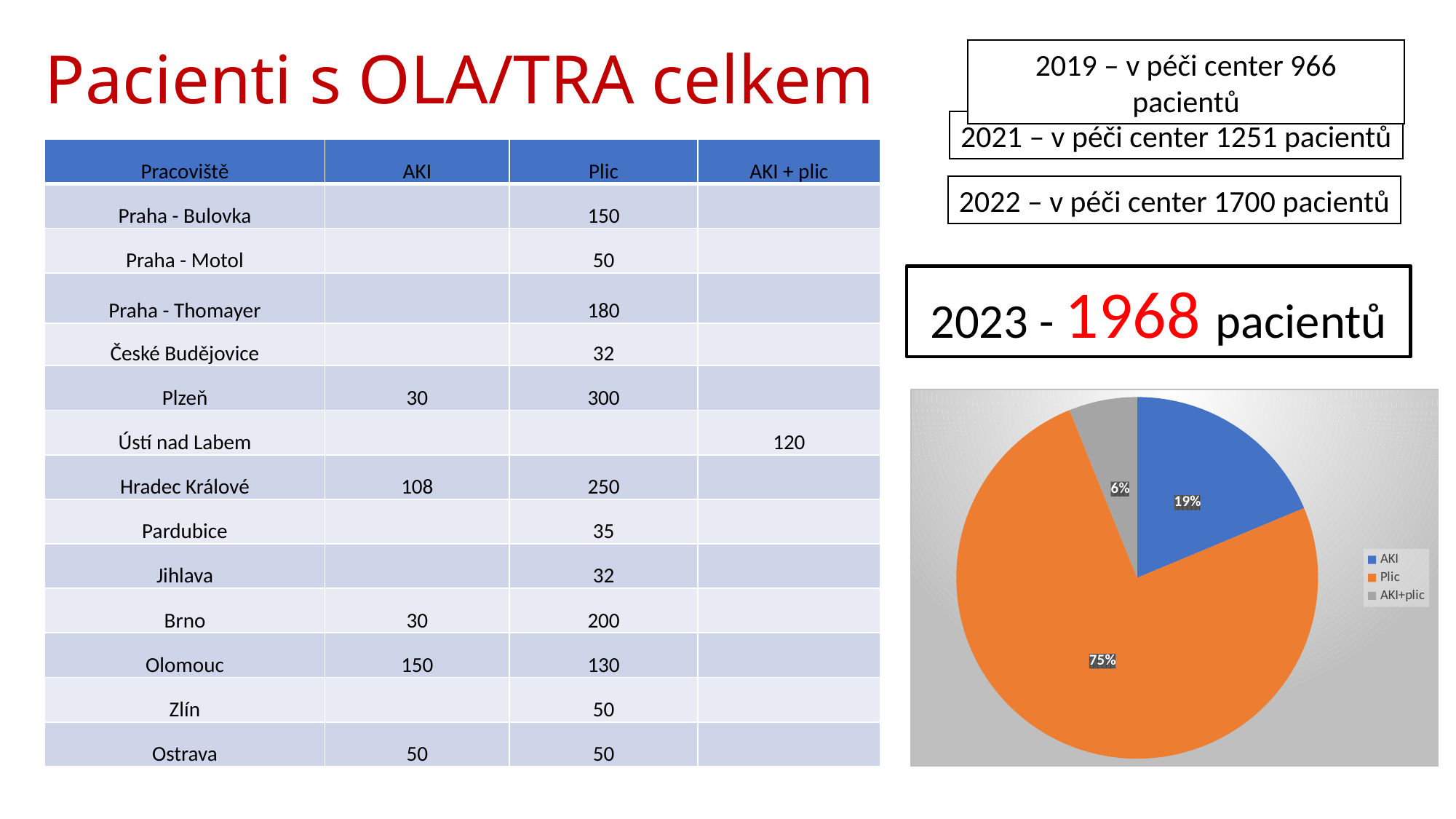
Which is larger in the pie chart, the AKI slice or the AKI+plic slice? AKI What share of the pie chart does the AKI+plic slice represent? 6% How many slices does the pie chart have? 3 What is the difference in percentage points between the Plic slice and the AKI slice in the pie chart? 56 What kind of chart is shown on the slide? pie chart Which category has the largest slice in the pie chart? Plic How many entries does the pie chart legend list? 3 Which category has the smallest slice in the pie chart? AKI+plic What are the legend entries of the pie chart, in order? AKI, Plic, AKI+plic What share of the pie chart does the AKI slice represent? 19% What share of the pie chart does the Plic slice represent? 75% What colour is the Plic slice in the pie chart? orange